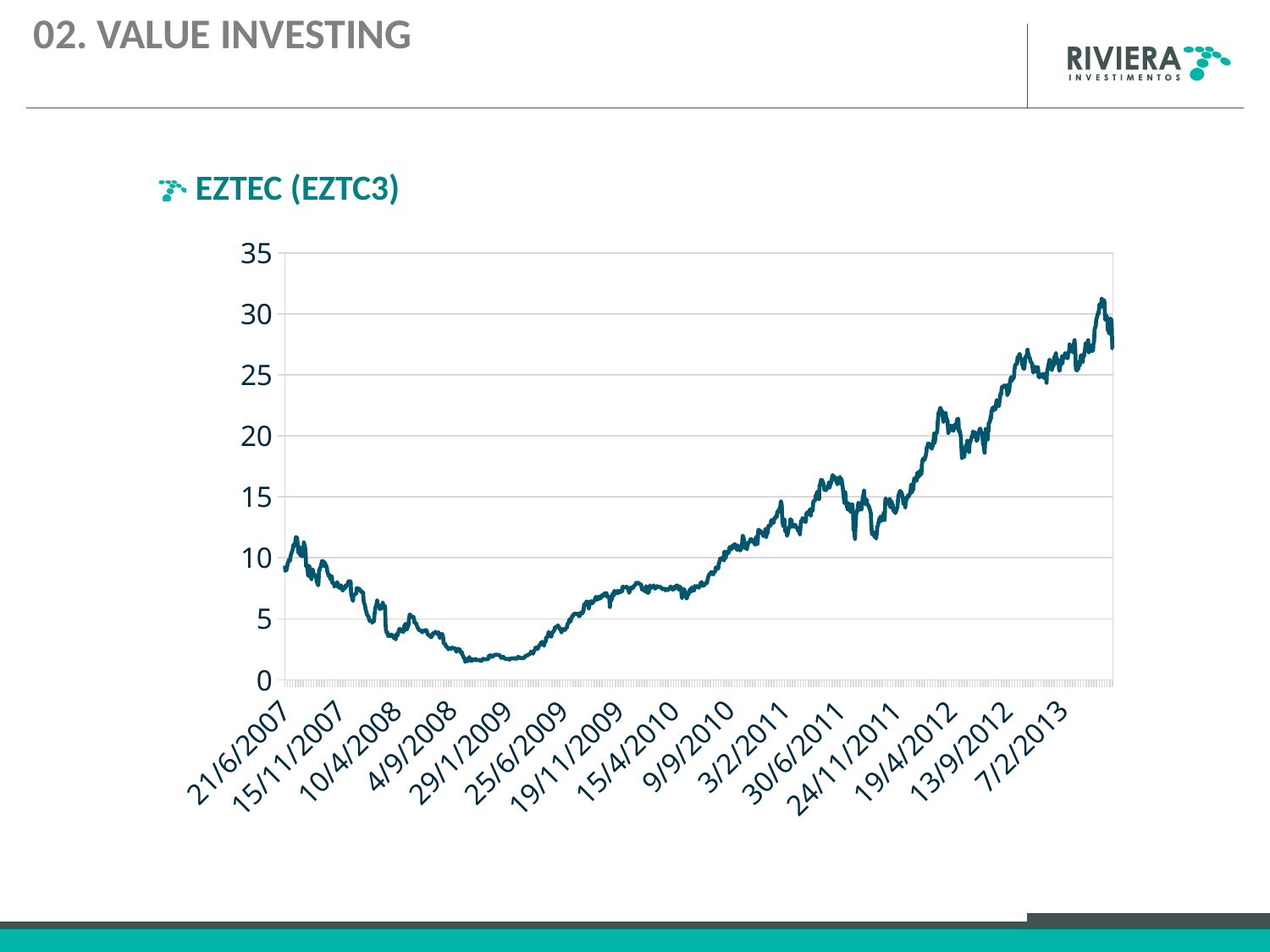
Does the line generally rise or fall between 29/1/2009 and 7/2/2013? rise Does the line generally rise or fall between 21/6/2007 and 29/1/2009? fall Is the value at 3/2/2011 greater or less than 20? less How many date labels are shown on the x axis of the chart? 15 What is the highest value shown on the y axis of the chart? 35 What kind of chart is shown on the slide? line chart Is the value at 15/4/2010 greater or less than 10? less What is the title of the chart? EZTEC (EZTC3) Is the value at 4/9/2008 greater or less than 5? less